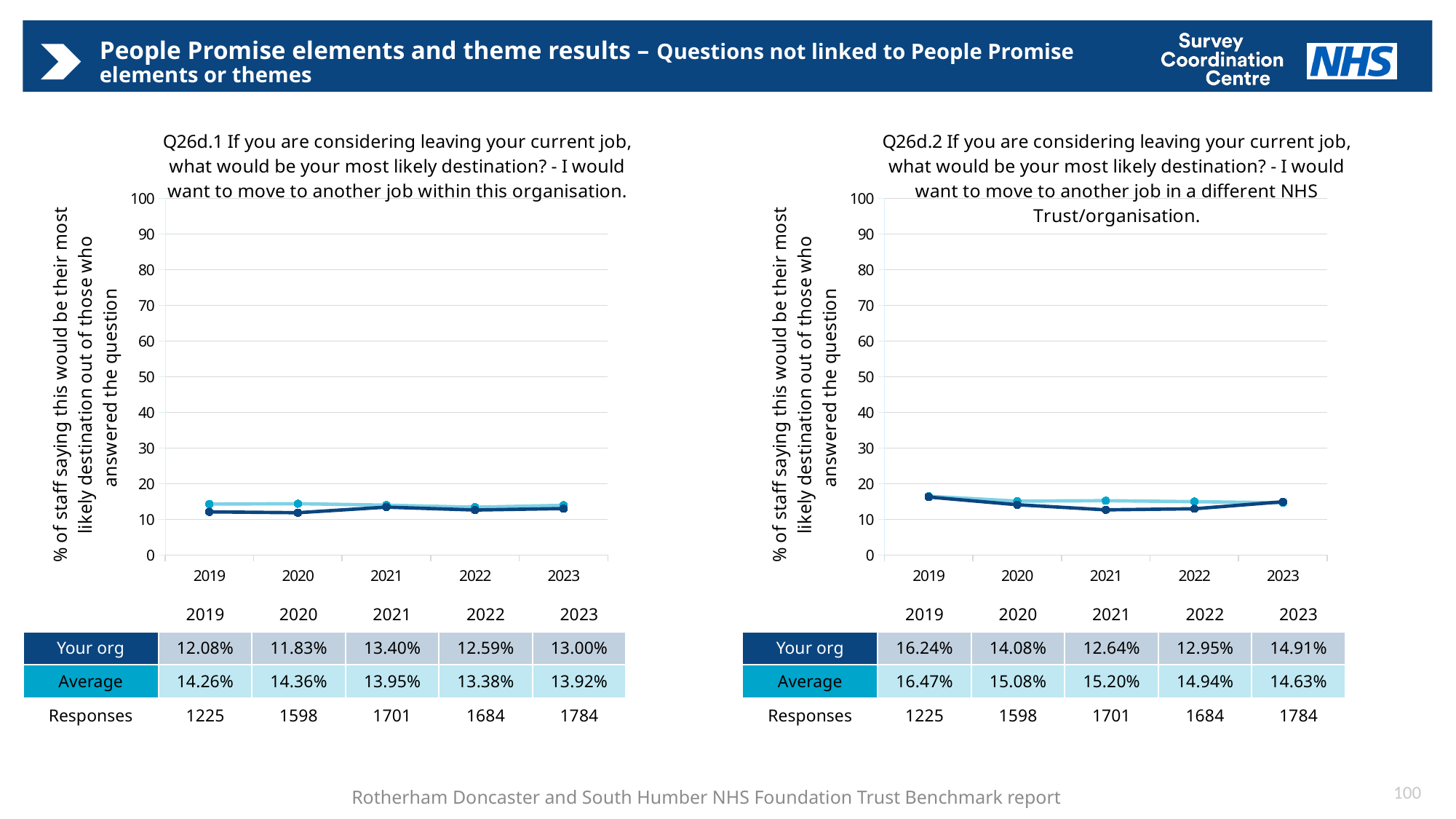
What kind of chart is the Q26d.2 chart (right)? line chart In the Q26d.2 chart (right), does the Average value rise or fall from 2019 to 2023? fall How many years are plotted on the x axis of the Q26d.1 chart (left)? 5 In the Q26d.1 chart (left), which is larger in 2019: the Your org value or the Average value? Average In the Q26d.1 chart (left), which year has the lowest Your org value? 2020 In the Q26d.2 chart (right), which year has the highest Your org value? 2019 In the Q26d.2 chart (right), is the Your org value for 2019 greater or less than 20? less In the Q26d.1 chart (left), what is the Your org value for 2021? 13.40% In the Q26d.1 chart (left), how many responses were recorded for 2023? 1784 How many data series are shown in the Q26d.1 chart (left)? 2 In the Q26d.2 chart (right), what is the difference between the Average and Your org values for 2021? 2.56% In the Q26d.2 chart (right), what is the Average value for 2020? 15.08%